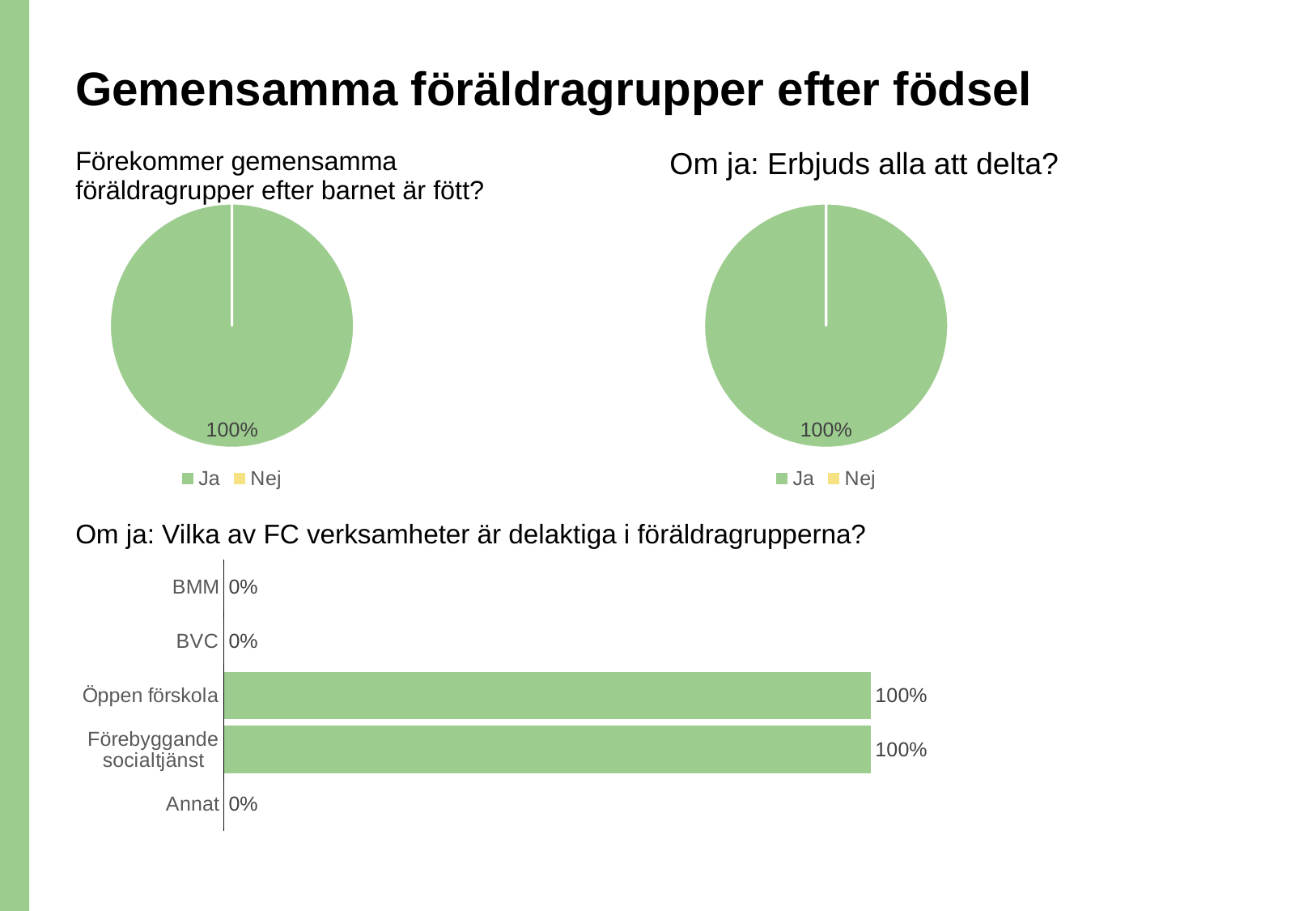
What kind of chart is the chart titled 'Förekommer gemensamma föräldragrupper efter barnet är fött?'? pie chart In the pie chart titled 'Om ja: Erbjuds alla att delta?', what share does 'Ja' have? 100% In the bar chart titled 'Om ja: Vilka av FC verksamheter är delaktiga i föräldragrupperna?', what is the value for 'BVC'? 0% In the bar chart titled 'Om ja: Vilka av FC verksamheter är delaktiga i föräldragrupperna?', how many categories are shown? 5 In the bar chart titled 'Om ja: Vilka av FC verksamheter är delaktiga i föräldragrupperna?', what is the value for 'Öppen förskola'? 100% What are the legend entries of the pie chart titled 'Förekommer gemensamma föräldragrupper efter barnet är fött?'? Ja, Nej In the bar chart titled 'Om ja: Vilka av FC verksamheter är delaktiga i föräldragrupperna?', what is the value for 'Förebyggande socialtjänst'? 100% In the bar chart titled 'Om ja: Vilka av FC verksamheter är delaktiga i föräldragrupperna?', what is the difference between 'Öppen förskola' and 'BMM'? 100% In the pie chart titled 'Förekommer gemensamma föräldragrupper efter barnet är fött?', what share does 'Ja' have? 100% How many entries does the legend of the pie chart titled 'Om ja: Erbjuds alla att delta?' list? 2 What kind of chart is the chart titled 'Om ja: Vilka av FC verksamheter är delaktiga i föräldragrupperna?'? bar chart In the bar chart titled 'Om ja: Vilka av FC verksamheter är delaktiga i föräldragrupperna?', which is larger, 'Öppen förskola' or 'Annat'? Öppen förskola